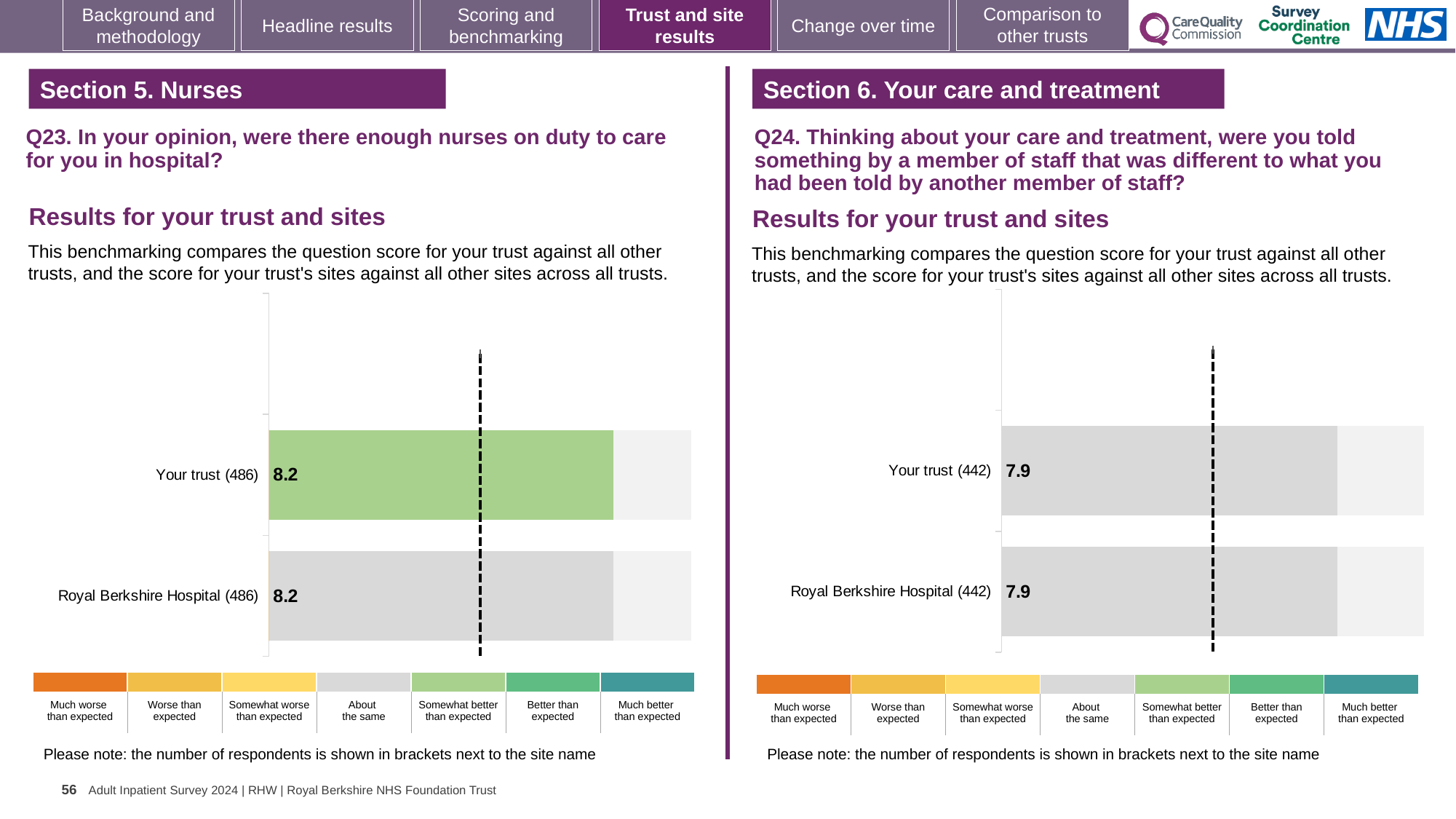
In the Q23 chart on the left, what is the difference between the score for Your trust and the score for Royal Berkshire Hospital? 0 In the Q23 chart on the left, how many respondents are shown in brackets for Your trust? 486 In the Q24 chart on the right, what is the difference between the score for Your trust and the score for Royal Berkshire Hospital? 0 In the Q23 chart on the left, which benchmark category does the colour of the Your trust bar correspond to? Somewhat better than expected In the Q24 chart on the right, what is the score for Your trust? 7.9 In the Q23 chart on the left, what is the score for Royal Berkshire Hospital? 8.2 In the Q24 chart on the right, how many respondents are shown in brackets for Royal Berkshire Hospital? 442 In the Q23 chart on the left, what is the score for Your trust? 8.2 How many bars are plotted in the Q24 chart on the right? 2 How many bars are plotted in the Q23 chart on the left? 2 In the Q24 chart on the right, what is the score for Royal Berkshire Hospital? 7.9 What kind of chart is the Q23 chart on the left? Bar chart